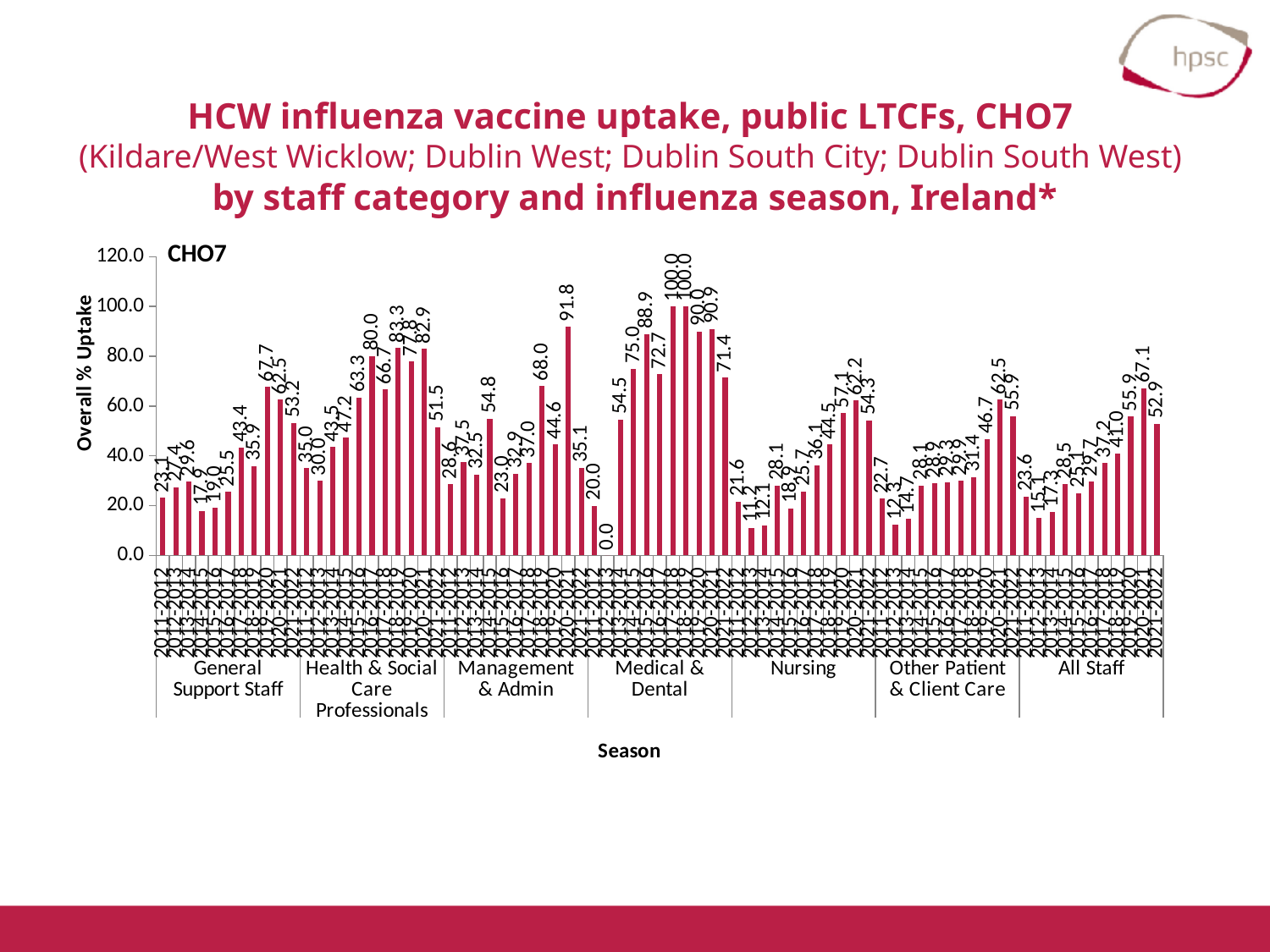
Which group has the higher peak value: Management & Admin or Nursing? Management & Admin What is the highest value shown in the Nursing group? 62.2 What is the value of the last (2021-2022) bar in the All Staff group? 52.9 What is the highest value shown in the Management & Admin group? 91.8 What is the highest value shown in the Medical & Dental group? 100.0 What kind of chart is shown on the slide? Bar chart What is the difference between the highest value in the All Staff group and the value of its last (2021-2022) bar? 14.2 How many staff category groups are shown along the x axis? 7 What is the title of the vertical axis? Overall % Uptake What is the lowest value shown in the Medical & Dental group? 0.0